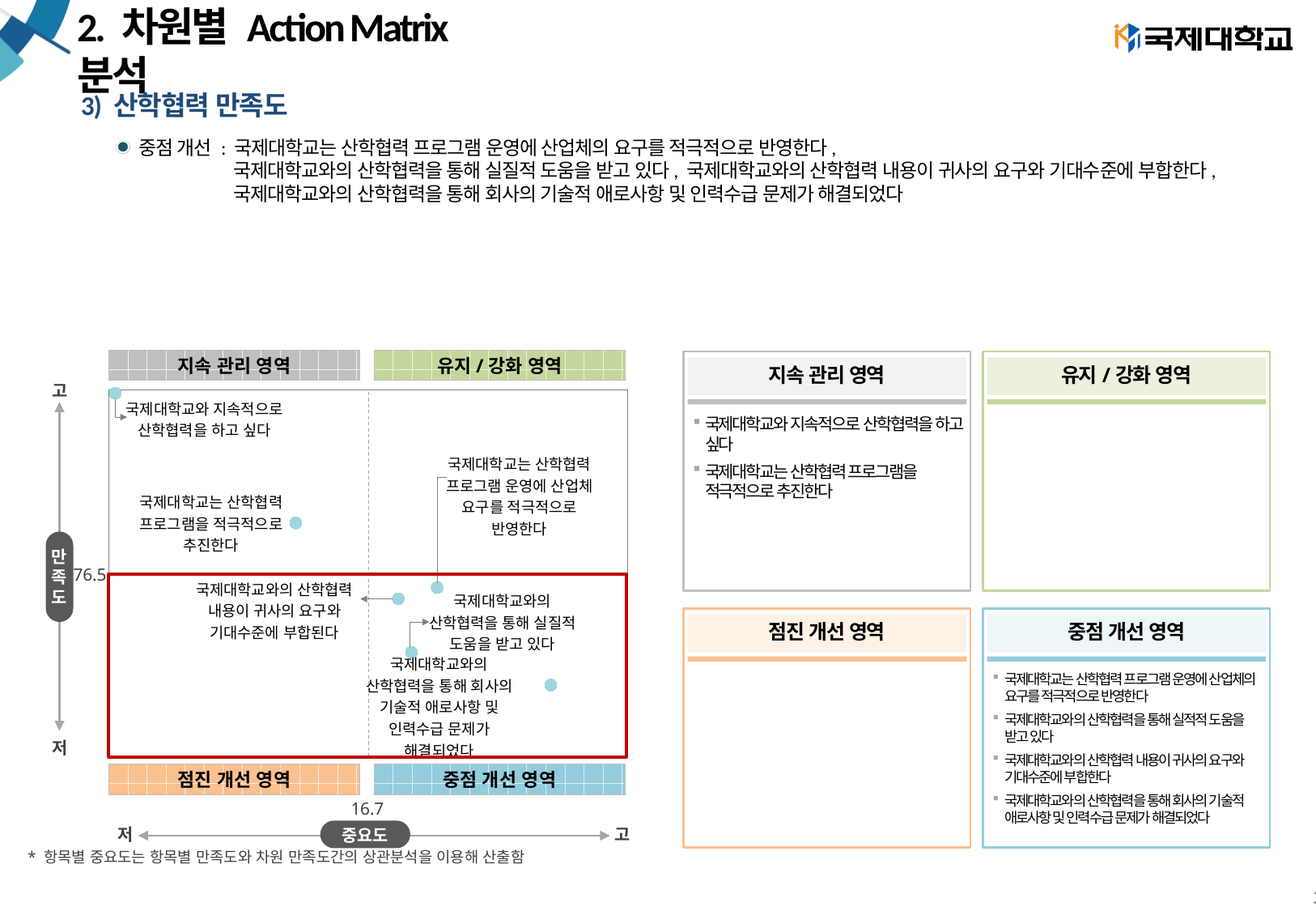
Which has the higher satisfaction: '국제대학교와 지속적으로 산학협력을 하고 싶다' or '국제대학교는 산학협력 프로그램을 적극적으로 추진한다'? 국제대학교와 지속적으로 산학협력을 하고 싶다 How many data points fall in the 지속 관리 영역 quadrant of the action matrix? 2 Is the importance value for '국제대학교와 지속적으로 산학협력을 하고 싶다' greater or less than 16.7? less How many data points are plotted in the action matrix chart? 6 What value marks the dividing line on the satisfaction (만족도) axis of the action matrix? 76.5 What kind of chart is shown on the left of the slide? scatter chart How many data points fall in the 유지 / 강화 영역 quadrant of the action matrix? 0 Which item has the highest satisfaction in the action matrix? 국제대학교와 지속적으로 산학협력을 하고 싶다 Is the satisfaction value for '국제대학교와의 산학협력을 통해 실질적 도움을 받고 있다' greater or less than 76.5? less Which quadrant of the action matrix contains the most data points? 중점 개선 영역 What value marks the dividing line on the importance (중요도) axis of the action matrix? 16.7 Is the satisfaction value for '국제대학교와 지속적으로 산학협력을 하고 싶다' greater or less than 76.5? greater